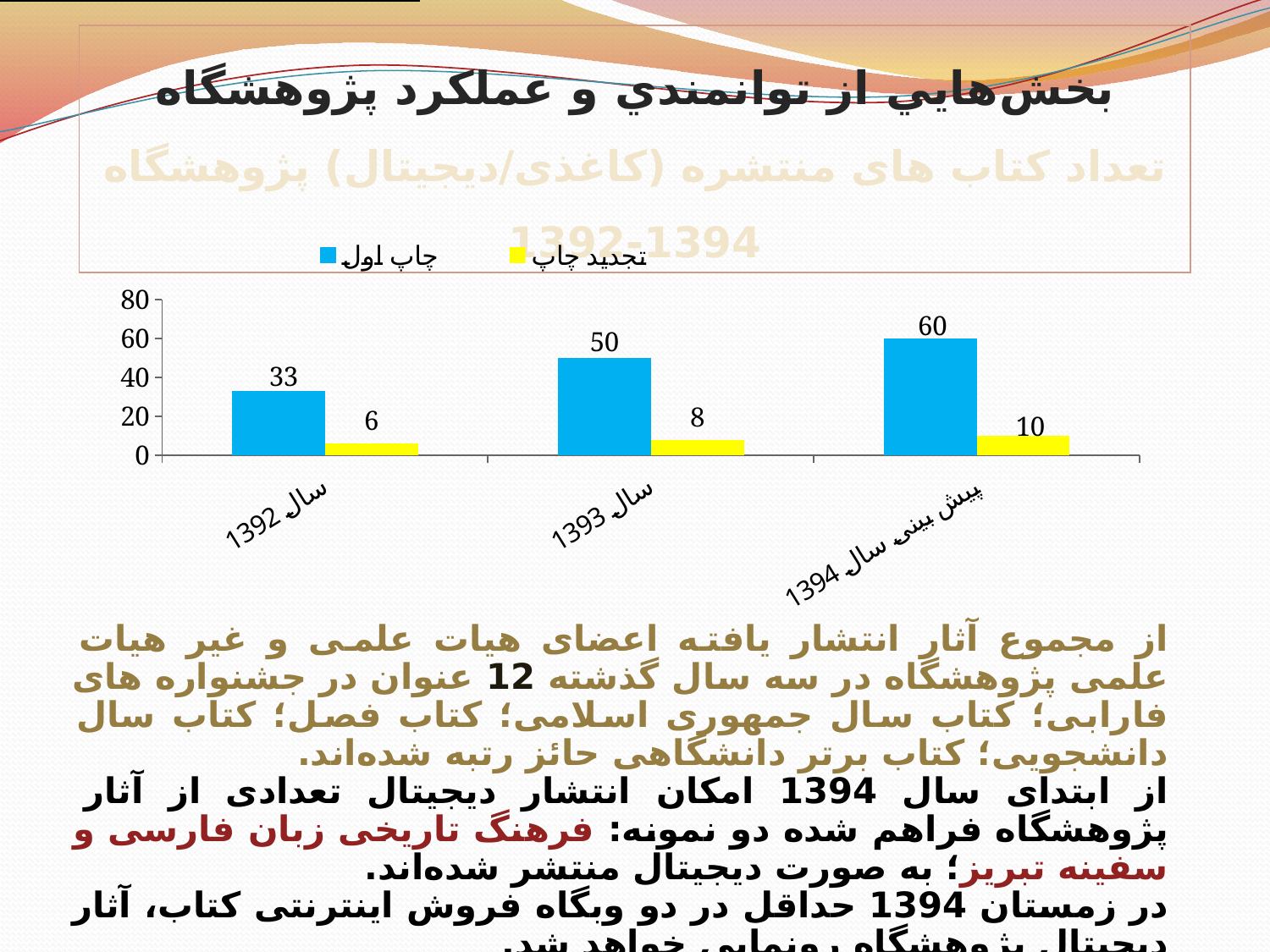
What colour are the bars for تجدید چاپ? yellow Which category has the lowest value for تجدید چاپ? سال 1392 What is the difference between چاپ اول and تجدید چاپ for سال 1393? 42 What is the value of تجدید چاپ for سال 1393? 8 How many series does the legend list? 2 Do the values for چاپ اول rise or fall from سال 1392 to پیش بینی سال 1394? rise What is the value of چاپ اول for پیش بینی سال 1394? 60 How many categories are shown on the x axis? 3 What kind of chart is shown on the slide? bar chart Which category has the highest value for چاپ اول? پیش بینی سال 1394 What is the value of چاپ اول for سال 1392? 33 Which is larger: چاپ اول for سال 1392 or چاپ اول for سال 1393? سال 1393